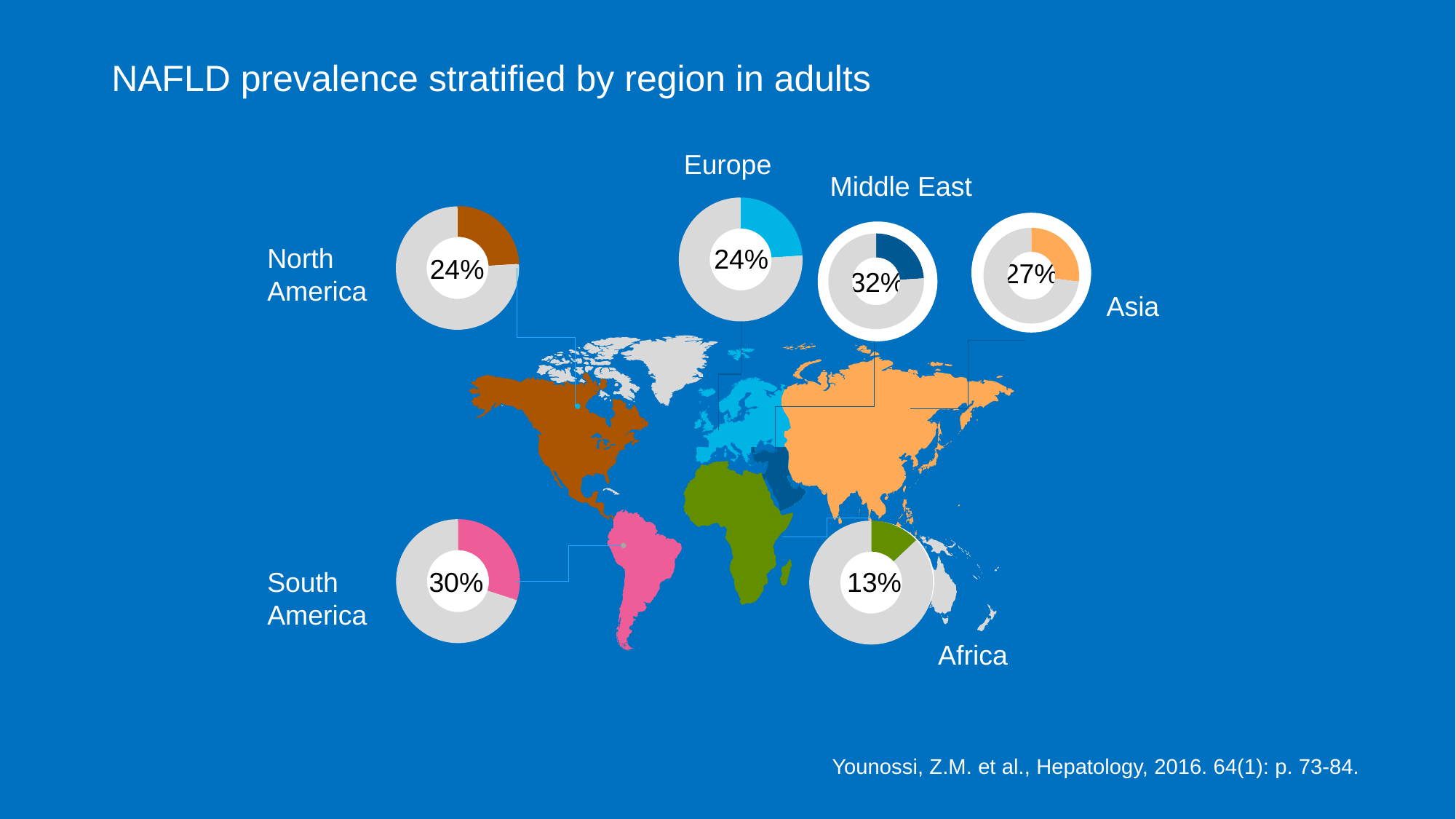
What colour is the filled segment of the Africa donut chart? Green What NAFLD prevalence is shown in the donut chart for the Middle East? 32% What NAFLD prevalence is shown in the donut chart for Asia? 27% What is the difference in NAFLD prevalence between the Middle East and Africa donut charts? 19 percentage points What kind of chart is used to show the NAFLD prevalence for each region? Donut (pie) chart What NAFLD prevalence is shown in the donut chart for South America? 30% Which region has the lowest NAFLD prevalence among the donut charts on the slide? Africa How many regional donut charts are shown on the slide? 6 Which region has the highest NAFLD prevalence among the donut charts on the slide? Middle East What NAFLD prevalence is shown in the donut chart for North America? 24% Which region shows a higher NAFLD prevalence, South America or Asia? South America What NAFLD prevalence is shown in the donut chart for Africa? 13%